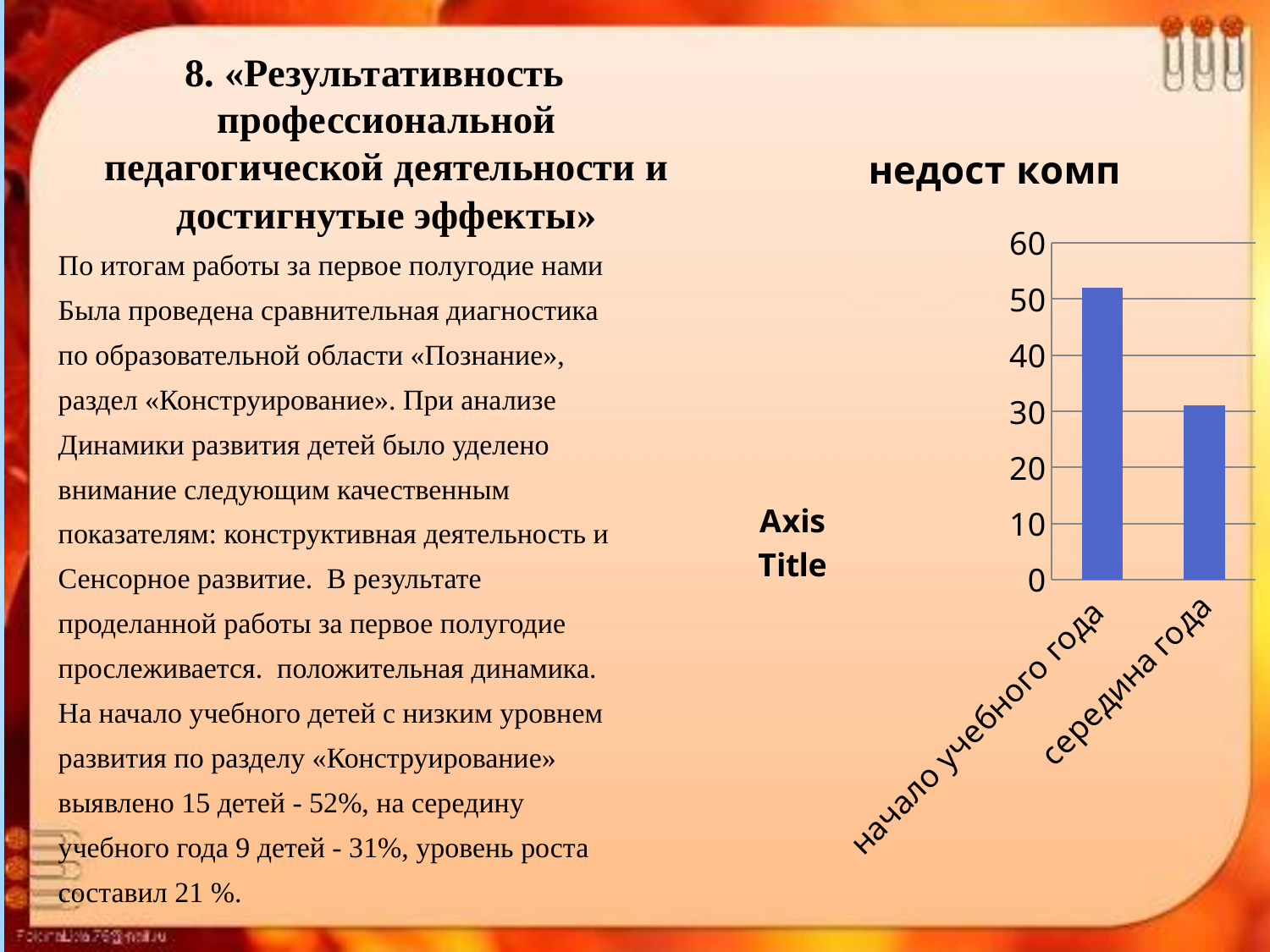
Is the value for начало учебного года greater or less than 50? greater Do the values rise or fall from начало учебного года to середина года? fall What is the highest value shown on the vertical axis? 60 Is the value for середина года greater or less than 40? less Which category has the highest bar? начало учебного года What kind of chart is shown on the slide? bar chart What is the title of the chart? недост комп Which is larger, the value for начало учебного года or the value for середина года? начало учебного года How many bars does the chart have? 2 Is the value for середина года greater or less than 20? greater Which category has the lowest bar? середина года